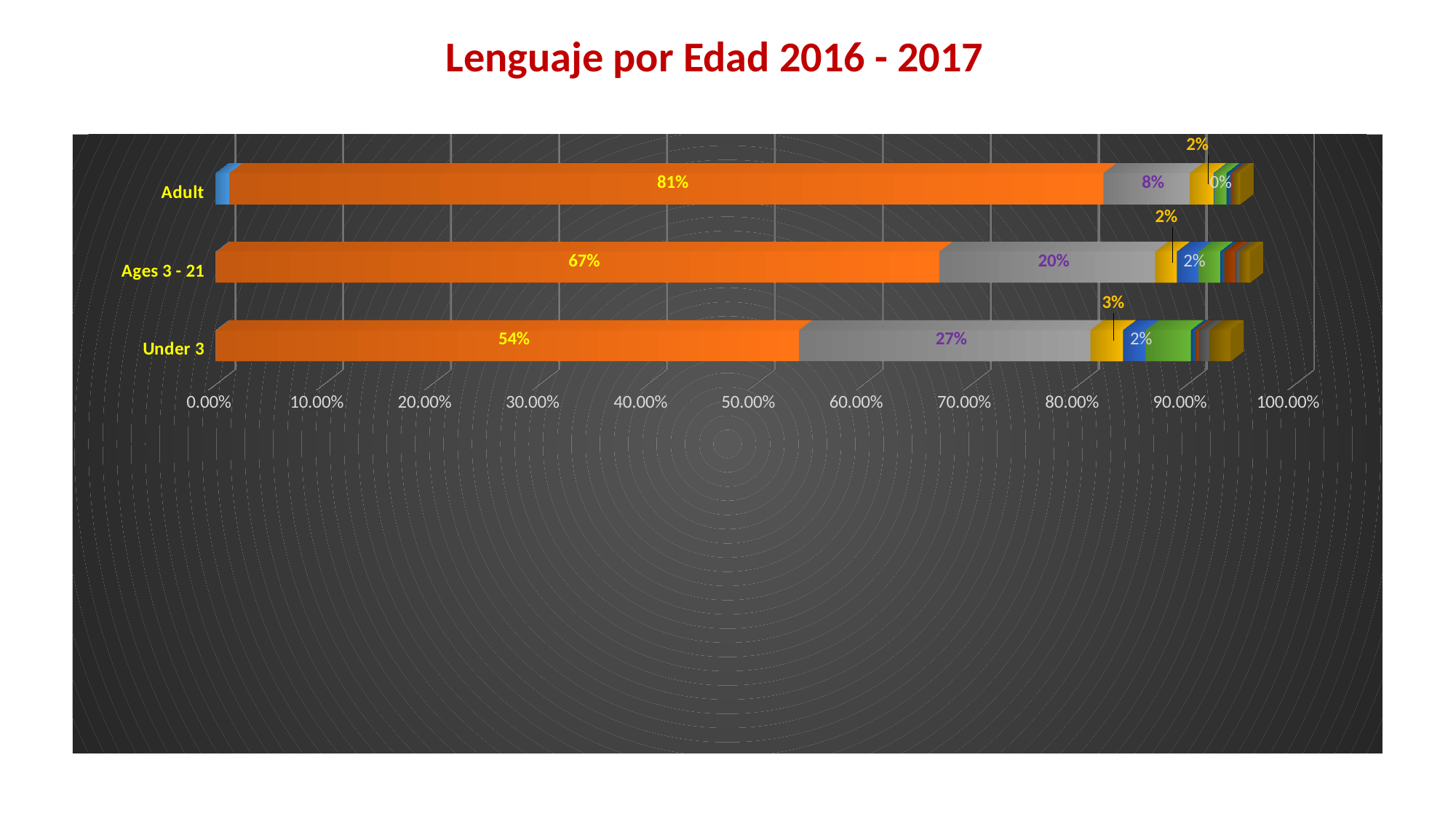
What is the difference between the orange segment for Adult and the orange segment for Ages 3 - 21? 14% What is the value of the yellow segment for Under 3? 3% Is the gray segment larger for Under 3 or for Ages 3 - 21? Under 3 Which age category has the largest orange segment? Adult What is the value of the gray segment for Under 3? 27% What is the value of the orange segment for Adult? 81% What is the value of the orange segment for Under 3? 54% What is the title of the chart? Lenguaje por Edad 2016 - 2017 How many age categories are shown on the chart? 3 What is the value of the gray segment for Ages 3 - 21? 20% Which age category has the smallest gray segment? Adult What kind of chart is shown on the slide? stacked bar chart